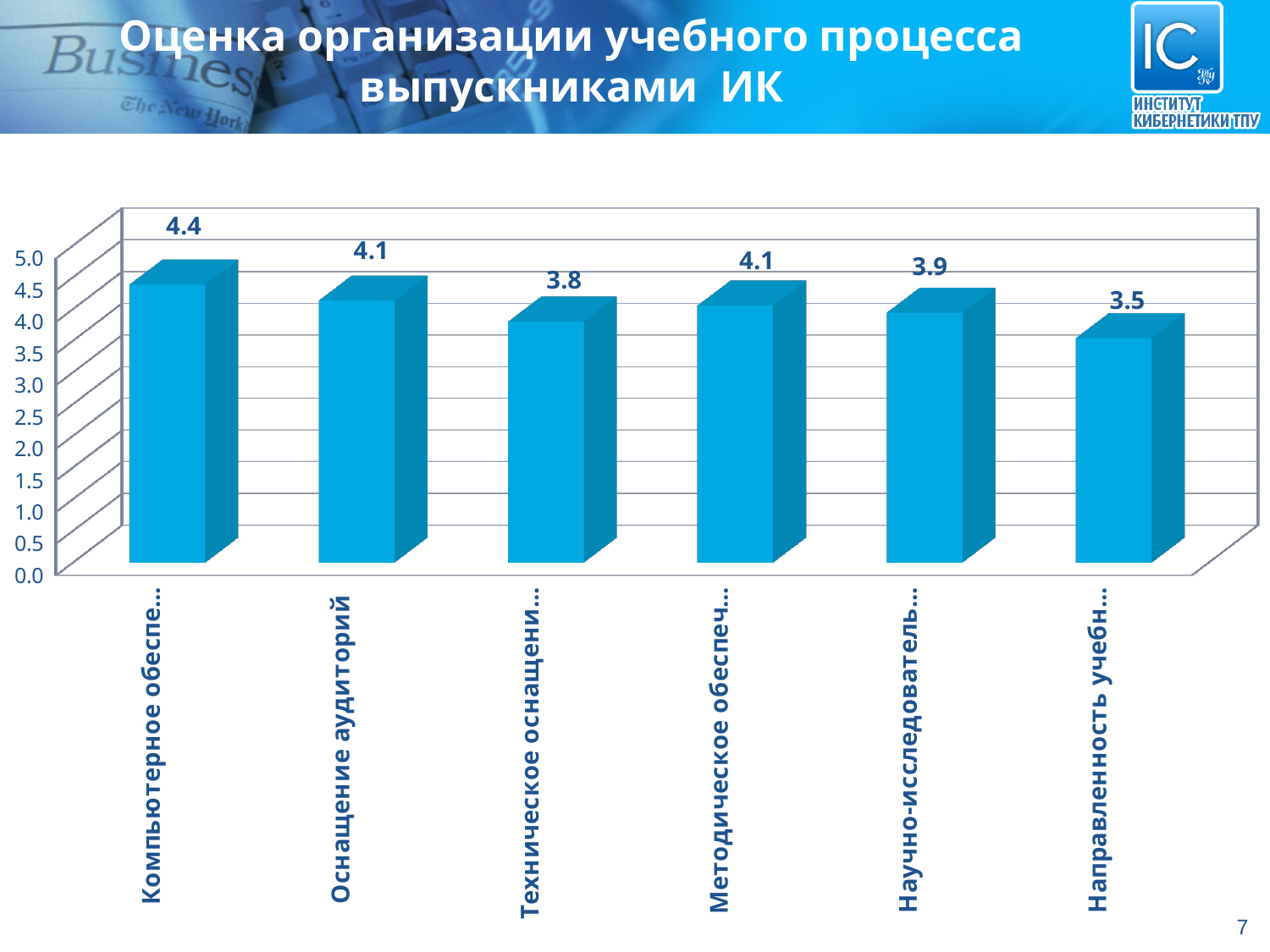
Which category has the highest value? Компьютерное обеспе… Which is larger: the value for "Техническое оснащени…" or the value for "Методическое обеспеч…"? Методическое обеспеч… Which category has the lowest value? Направленность учебн… What is the difference between the highest value (4.4) and the lowest value (3.5)? 0.9 What is the value for "Оснащение аудиторий"? 4.1 What is the value of the last bar, labelled "Направленность учебн…"? 3.5 What is the title of the slide containing the chart? Оценка организации учебного процесса выпускниками ИК What is the value of the bar labelled "Техническое оснащени…"? 3.8 What kind of chart is shown on the slide? bar chart What is the value of the first bar, labelled "Компьютерное обеспе…"? 4.4 How many bars (categories) does the chart show? 6 What is the value of the bar labelled "Научно-исследователь…"? 3.9